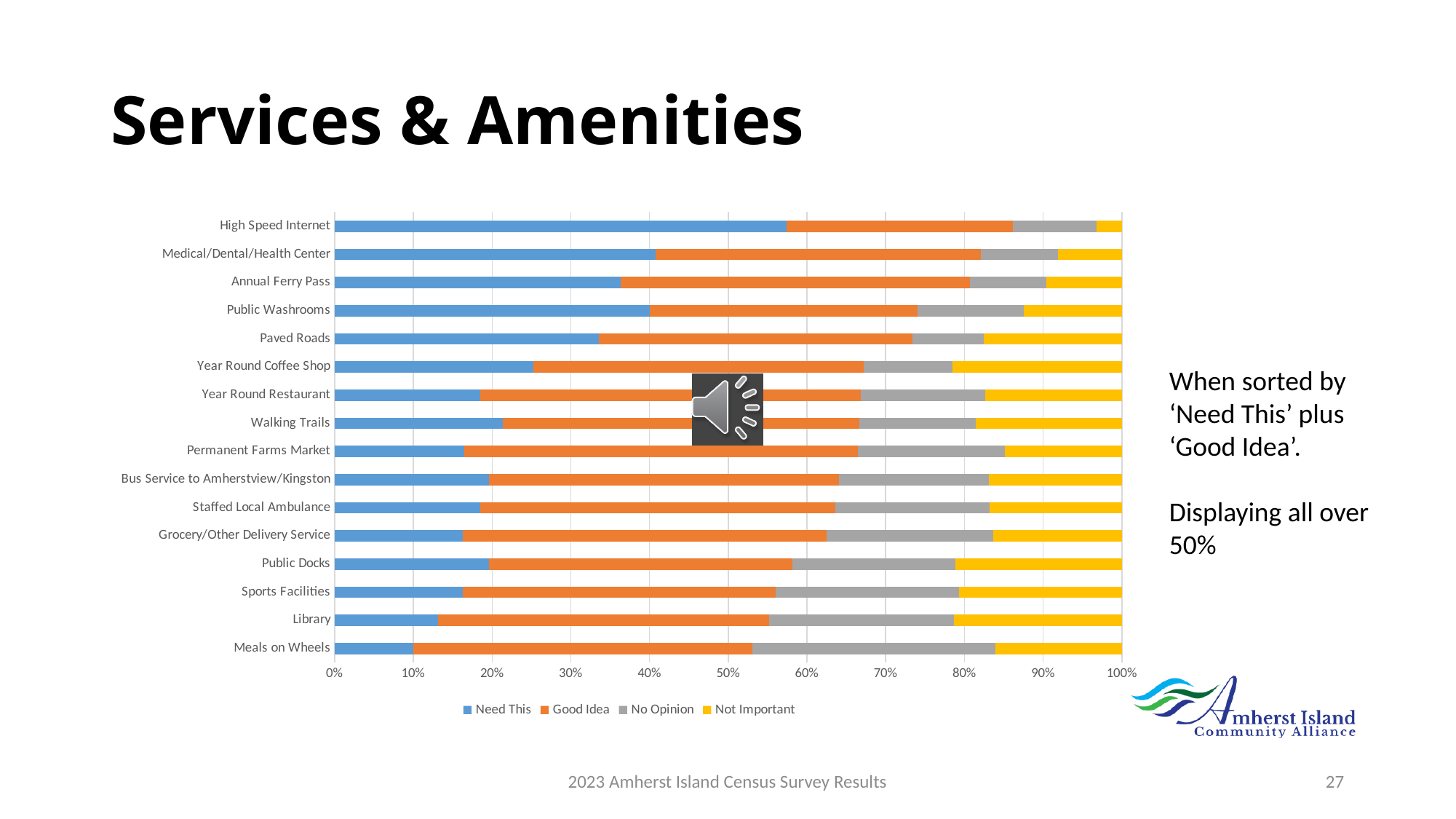
What kind of chart is shown on the slide? Stacked bar chart How many series does the chart legend list? 4 Is the 'Need This' value for High Speed Internet greater or less than 50%? greater How many services or amenities are listed on the chart? 16 Which series is shown in yellow in the chart legend? Not Important Is the 'Need This' value for Annual Ferry Pass greater or less than 40%? less Which has a larger 'Need This' share, Year Round Coffee Shop or Year Round Restaurant? Year Round Coffee Shop Which service or amenity has the smallest 'Need This' share? Meals on Wheels Which has a larger 'Need This' share, High Speed Internet or Medical/Dental/Health Center? High Speed Internet Is the 'Need This' value for Paved Roads greater or less than 30%? greater Which service or amenity has the largest 'Need This' share? High Speed Internet What is the title of the slide containing the chart? Services & Amenities